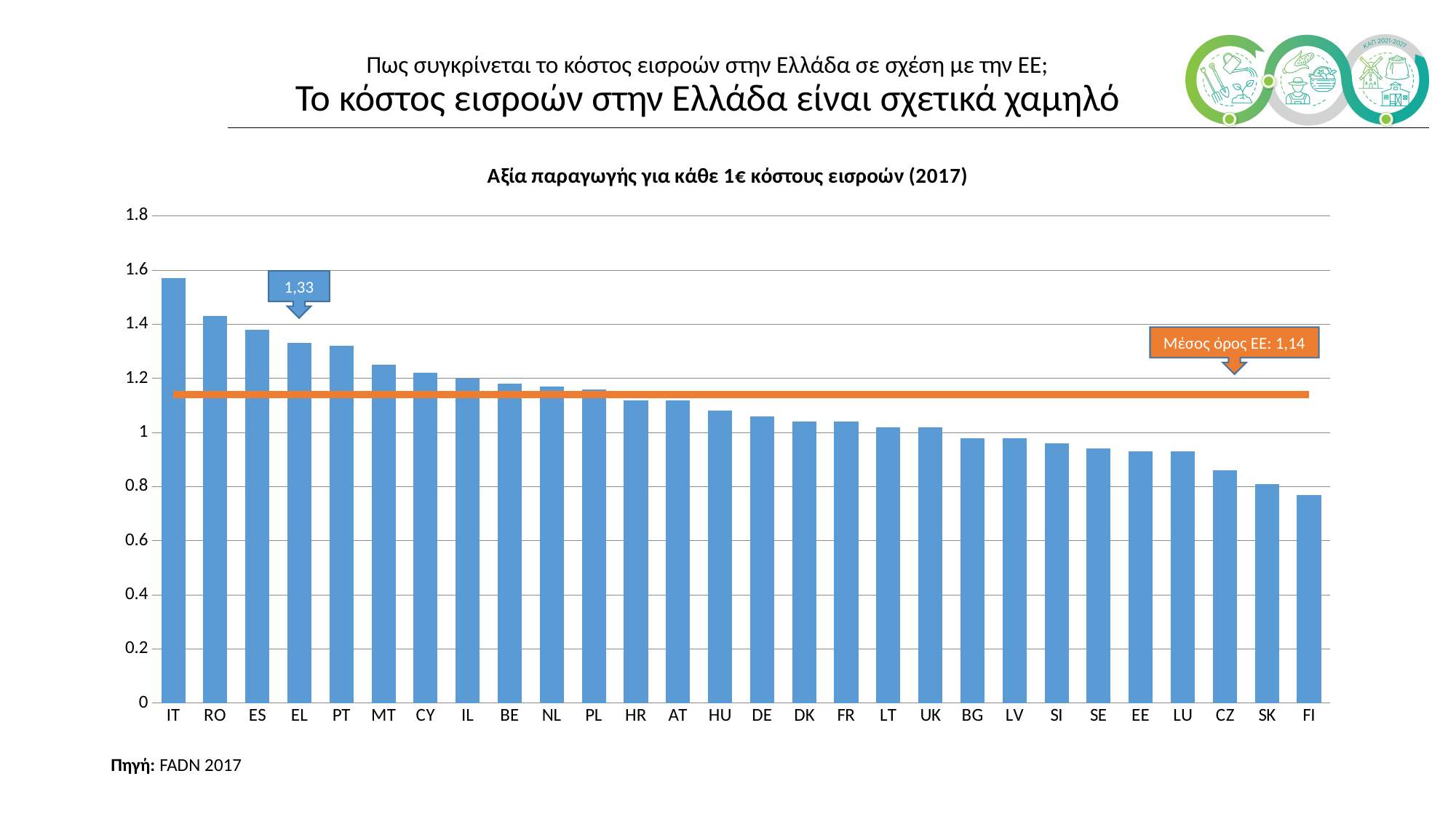
Which country has the highest value in the chart? IT Do the values rise or fall moving from left to right along the x axis? Fall What is the EU average (Μέσος όρος ΕΕ) shown on the chart? 1,14 What is the title of the chart? Αξία παραγωγής για κάθε 1€ κόστους εισροών (2017) Which has the larger value, IT or RO? IT What value is labelled on the bar for EL? 1,33 How many countries are shown on the x axis of the chart? 28 Is the value for IT greater or less than 1.4? greater Which country has the lowest value in the chart? FI By how much does the labelled value for EL exceed the EU average of 1,14? 0,19 Is the value for FI greater or less than 0.8? less What kind of chart is shown on the slide? Bar chart